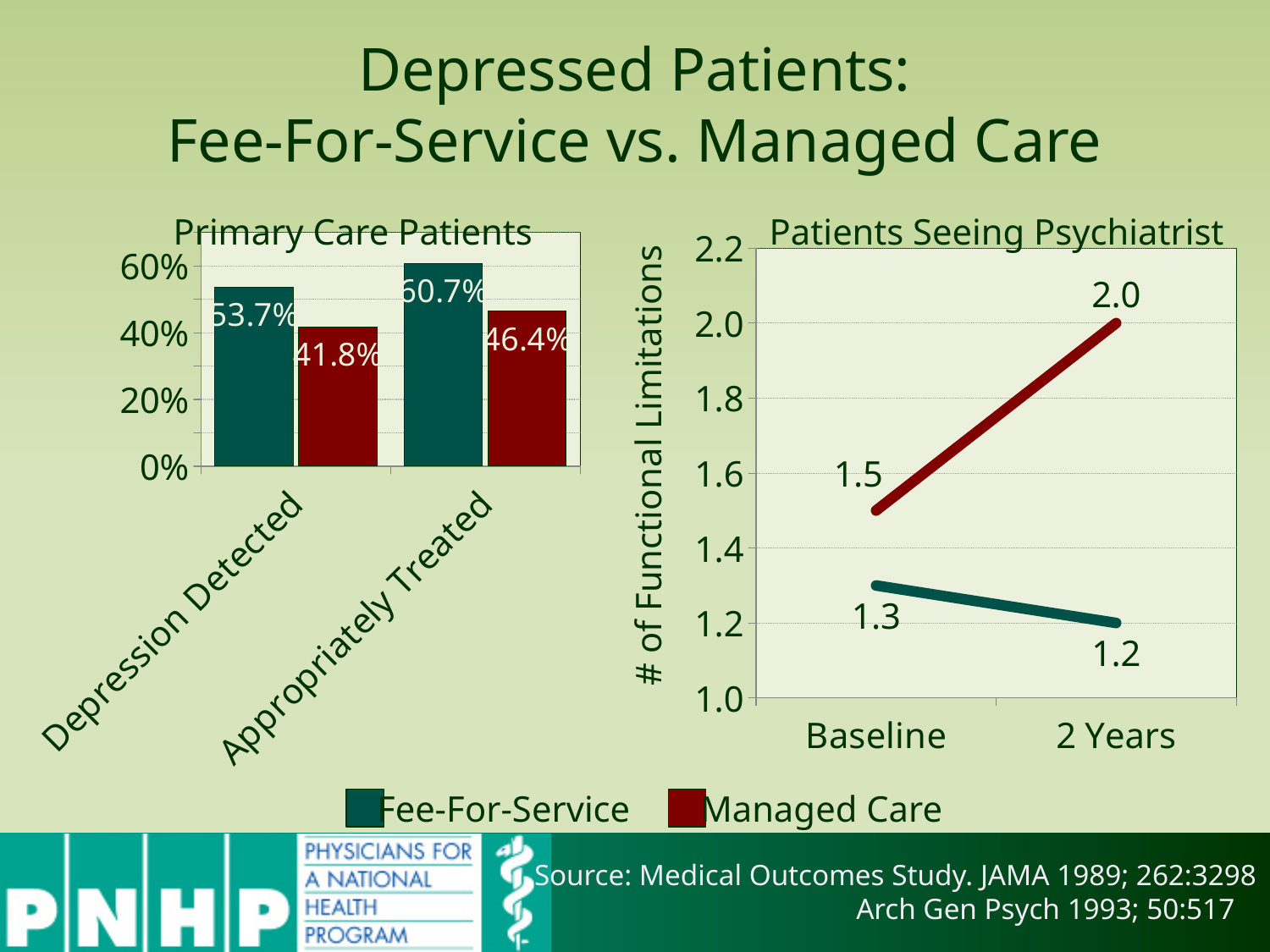
What kind of chart is the Patients Seeing Psychiatrist chart? Line chart In the Primary Care Patients chart, what is the difference between Fee-For-Service and Managed Care for Depression Detected? 11.9% What kind of chart is the Primary Care Patients chart? Bar chart In the Primary Care Patients chart, which series has the higher value for Appropriately Treated? Fee-For-Service In the Patients Seeing Psychiatrist chart, by how much did the Managed Care value change from Baseline to 2 Years? 0.5 In the Primary Care Patients chart, which bar has the highest value? Fee-For-Service, Appropriately Treated (60.7%) In the Patients Seeing Psychiatrist chart, what is the Fee-For-Service value at Baseline? 1.3 How many series does the legend list? 2 In the Primary Care Patients chart, what percentage of Fee-For-Service patients had depression detected? 53.7% In the Patients Seeing Psychiatrist chart, what is the Managed Care value at 2 Years? 2.0 In the Patients Seeing Psychiatrist chart, does the Managed Care line rise or fall from Baseline to 2 Years? Rises In the Primary Care Patients chart, what percentage of Managed Care patients were appropriately treated? 46.4%